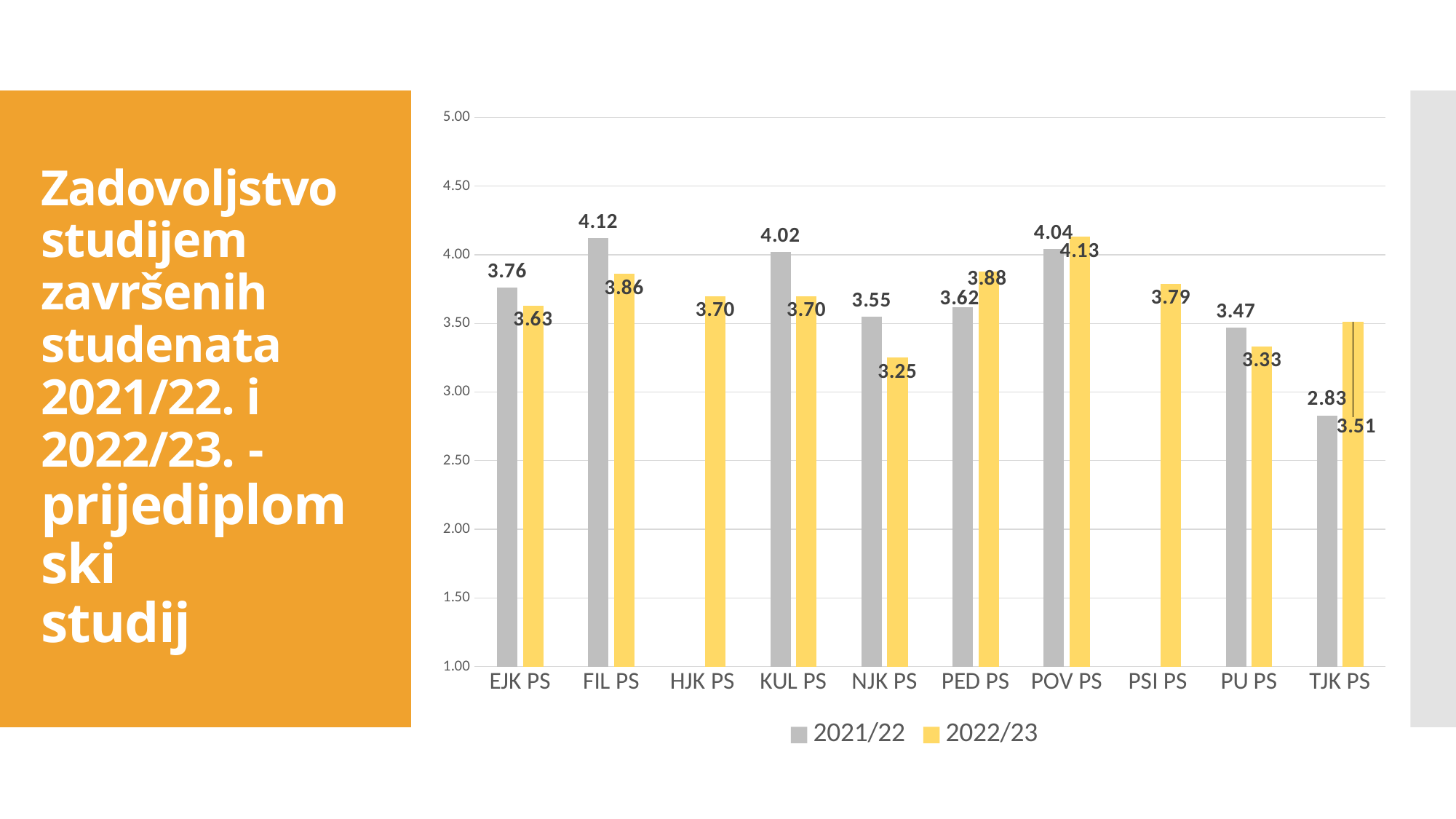
What is the value for PSI PS in 2022/23? 3.79 What kind of chart is shown on the slide? Bar chart Which category has the highest value in the 2022/23 series? POV PS Which category has the lowest value in the 2021/22 series? TJK PS Which series is shown in yellow? 2022/23 How many series does the legend list? 2 Which category has the highest value in the 2021/22 series? FIL PS What is the value for NJK PS in 2022/23? 3.25 For PED PS, which is larger: the 2021/22 value or the 2022/23 value? 2022/23 How many categories are shown on the x axis? 10 What is the value for FIL PS in 2021/22? 4.12 What is the difference between the 2022/23 and 2021/22 values for TJK PS? 0.68